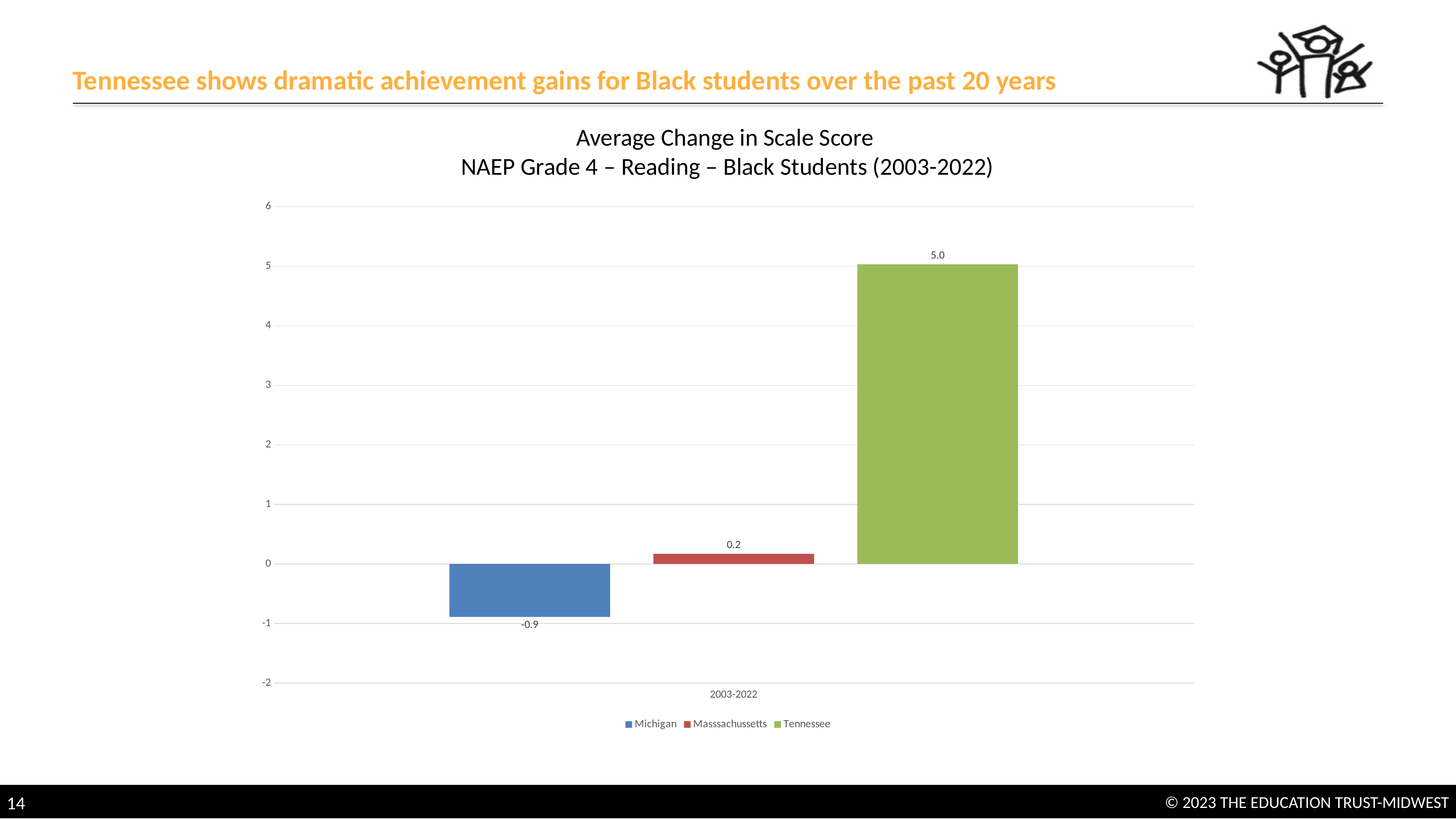
Which series has the lowest value? Michigan Which series has the highest value? Tennessee What is the difference between the values for Tennessee and Masssachussetts? 4.8 Which is larger, the value for Michigan or the value for Masssachussetts? Masssachussetts What kind of chart is shown on the slide? bar chart Is the value for Tennessee greater or less than 4? greater What is the difference between the values for Masssachussetts and Michigan? 1.1 What colour is the bar for Tennessee? green What is the value for Michigan? -0.9 What is the value for Tennessee? 5.0 How many series does the legend list? 3 What is the value for Masssachussetts? 0.2